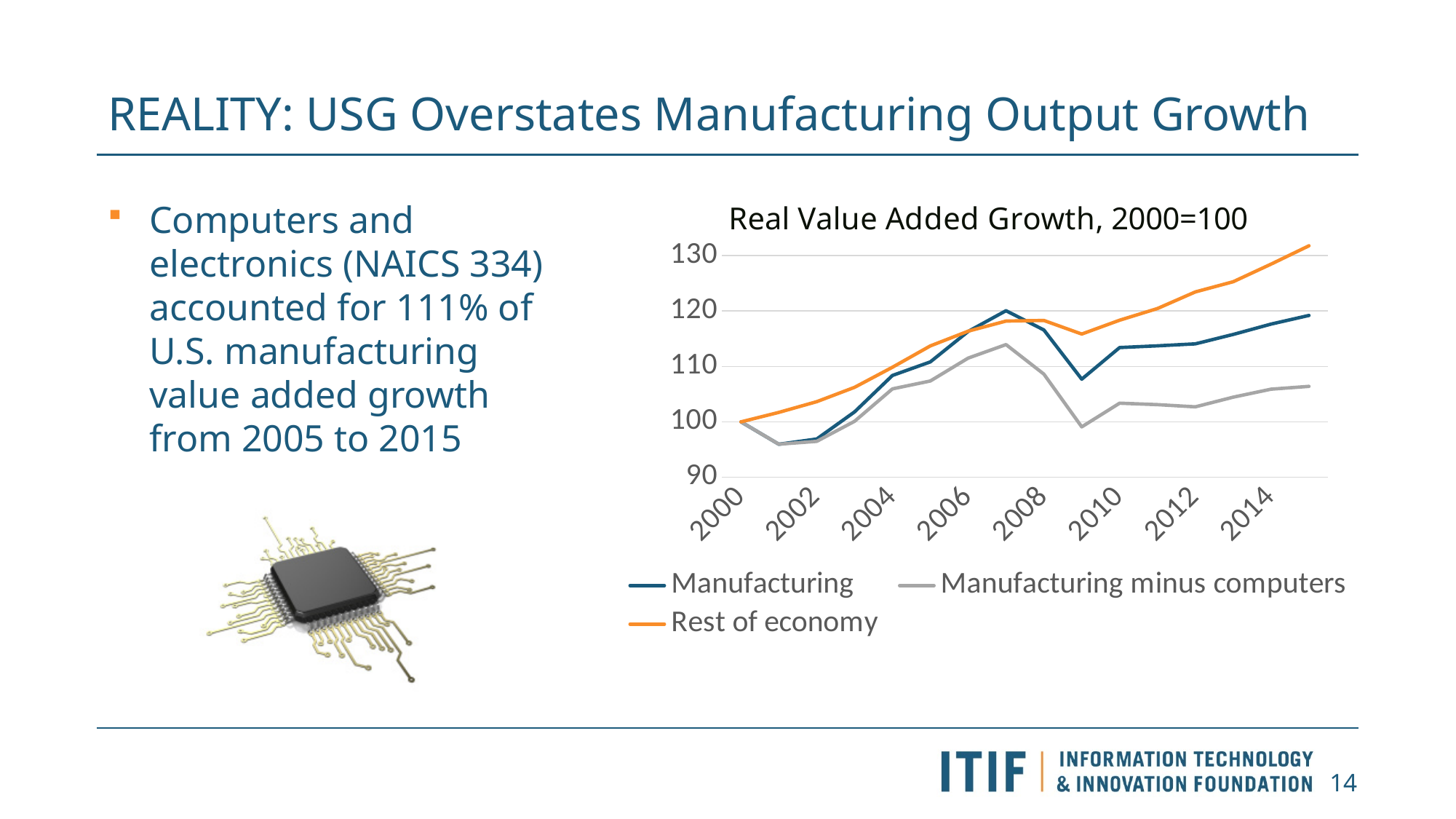
What is the title of the chart? Real Value Added Growth, 2000=100 Is the value for Manufacturing in 2007 greater or less than 110? greater Is the value for Rest of economy in 2014 greater or less than 120? greater Which series has the highest value at the right end of the chart (2015)? Rest of economy Which series has the lowest value at the right end of the chart (2015)? Manufacturing minus computers How many series does the legend of the chart list? 3 Does the Manufacturing series rise or fall from 2007 to 2009? fall What kind of chart is shown on the slide? line chart Is the value for Manufacturing minus computers in 2001 greater or less than 100? less What is the value of the Manufacturing series in 2000? 100 In 2009, which is larger: Rest of economy or Manufacturing? Rest of economy Does the Rest of economy series rise or fall from 2009 to 2015? rise